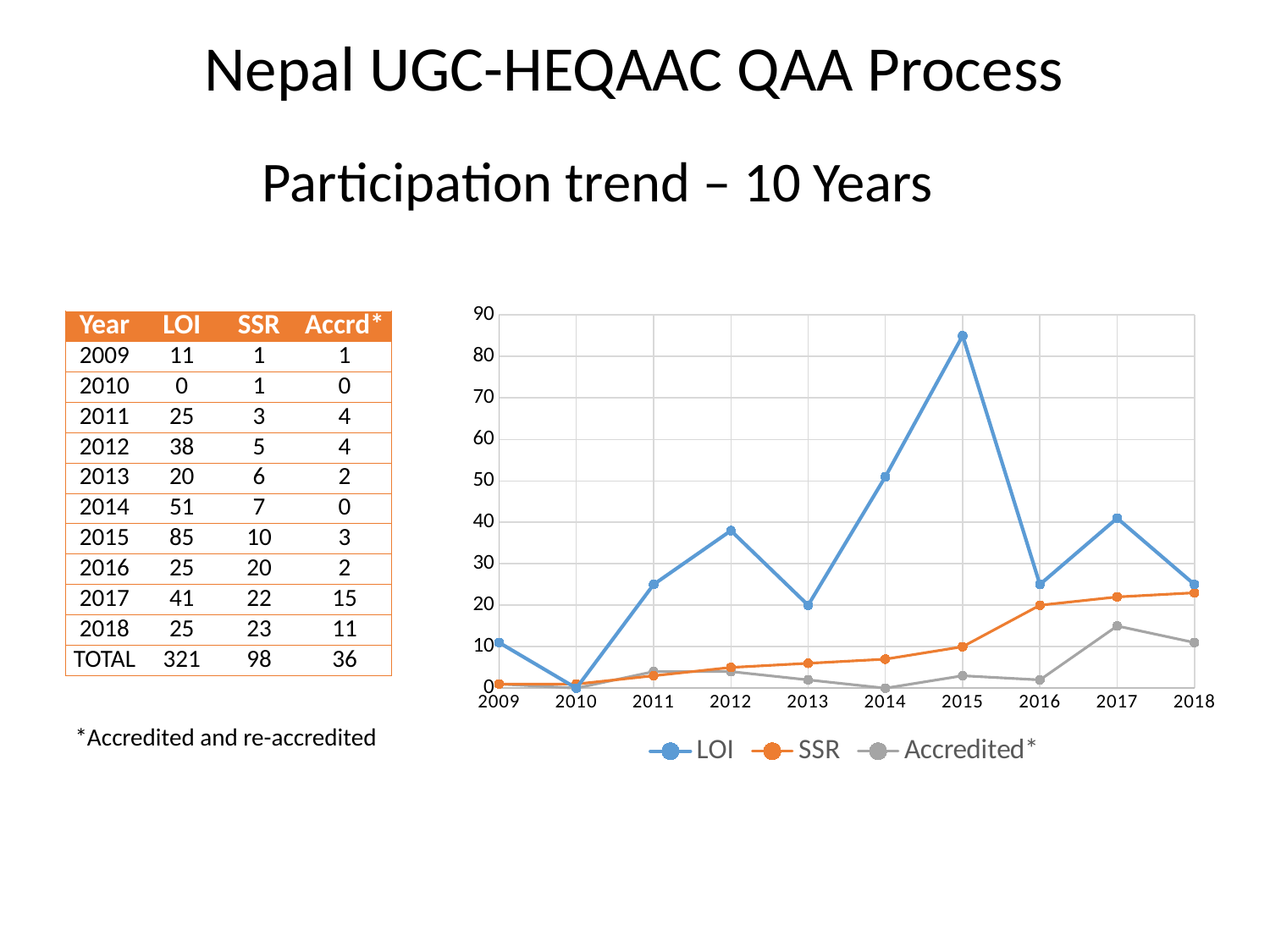
Which is larger in 2016, the LOI value or the SSR value? LOI Does the SSR series generally rise or fall from 2009 to 2018? rise Is the LOI value for 2014 greater or less than 40? greater In which year is the LOI value lowest? 2010 How many years are plotted along the x axis of the chart? 10 What type of chart is shown on the slide? line chart In which year does the LOI series reach its highest value? 2015 What is the LOI value for 2015? 85 How many series does the chart legend list? 3 What is the SSR value for 2018? 23 What is the Accredited* value for 2017? 15 What is the difference between the LOI value in 2015 and the LOI value in 2016? 60